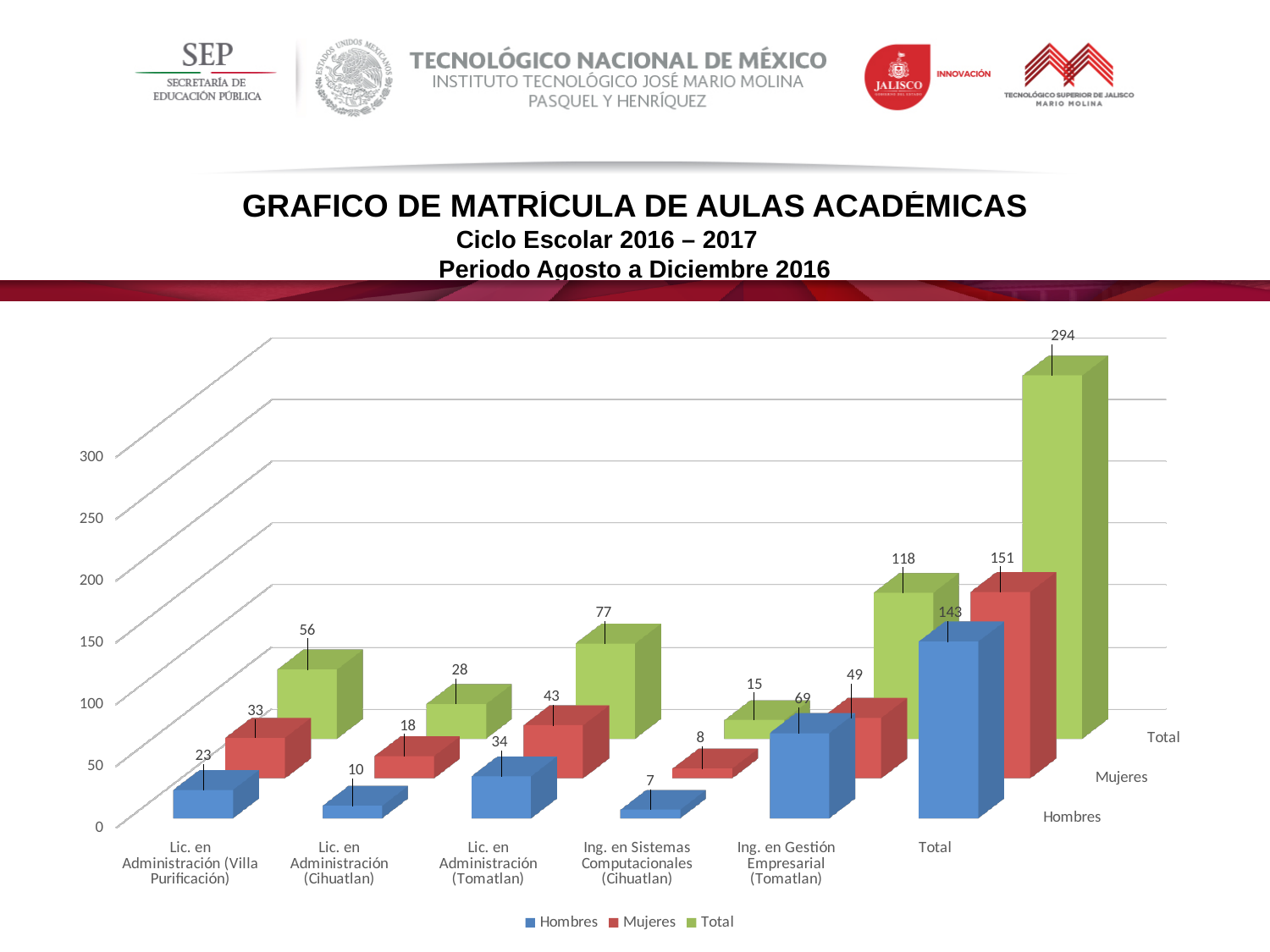
For Ing. en Gestión Empresarial (Tomatlan), which is larger, Hombres or Mujeres? Hombres What is the difference between the Mujeres and Hombres values for Lic. en Administración (Cihuatlan)? 8 What is the Mujeres value for Lic. en Administración (Tomatlan)? 43 How many categories are shown along the x axis? 6 Excluding the Total category, which category has the highest Hombres value? Ing. en Gestión Empresarial (Tomatlan) What kind of chart is shown on the slide? bar chart What is the Mujeres value for the Total category? 151 What is the Hombres value for Lic. en Administración (Villa Purificación)? 23 Which series is shown in green in the legend? Total What is the Total value for Ing. en Gestión Empresarial (Tomatlan)? 118 How many series does the legend list? 3 Excluding the Total category, which category has the lowest Total value? Ing. en Sistemas Computacionales (Cihuatlan)